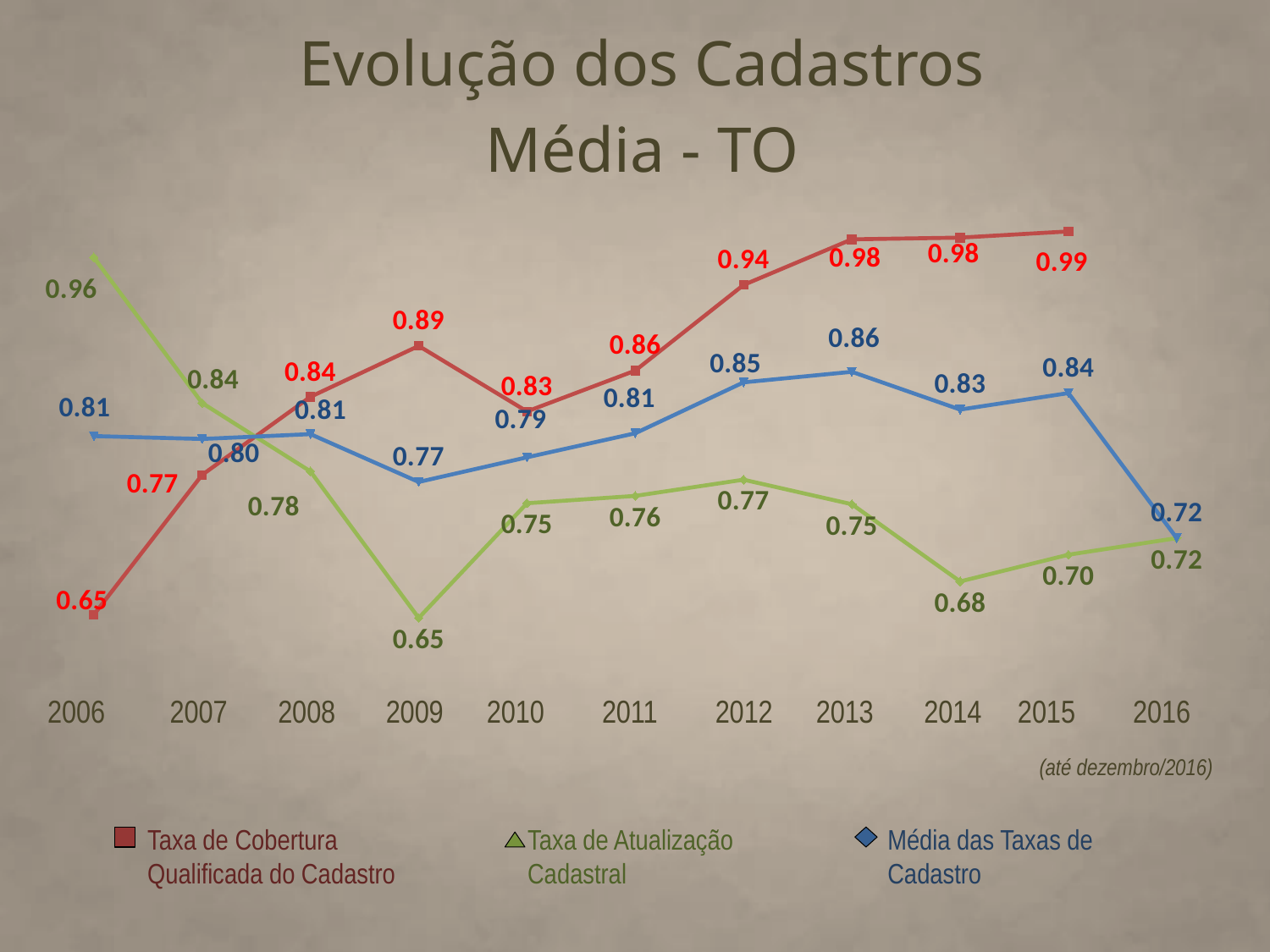
In which year is Taxa de Atualização Cadastral lowest? 2009 Which is larger in 2009: Taxa de Cobertura Qualificada do Cadastro or Taxa de Atualização Cadastral? Taxa de Cobertura Qualificada do Cadastro How many years are shown on the x axis? 11 What type of chart is shown on the slide? line chart What is the title of the chart? Evolução dos Cadastros Média - TO What is the value of Taxa de Cobertura Qualificada do Cadastro in 2012? 0.94 What is the difference between Taxa de Cobertura Qualificada do Cadastro in 2015 and in 2006? 0.34 How many series does the legend list? 3 In which year is Média das Taxas de Cadastro highest? 2013 What is the value of Média das Taxas de Cadastro in 2016? 0.72 Does Taxa de Atualização Cadastral rise or fall from 2006 to 2009? fall What is the value of Taxa de Atualização Cadastral in 2006? 0.96